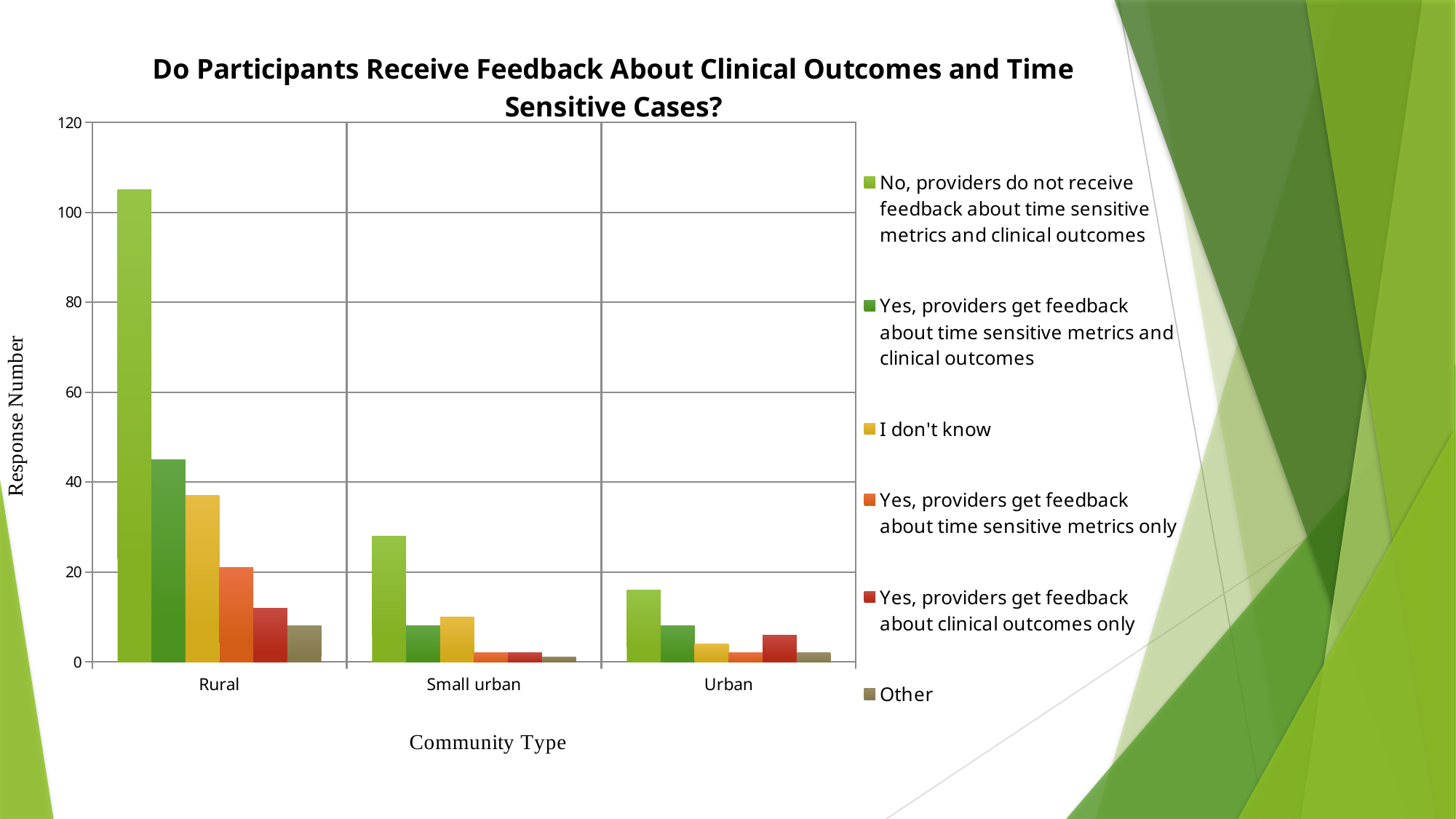
Which series has the lowest bar in the Rural group? Other In Rural, which is larger: "I don't know" or "Yes, providers get feedback about time sensitive metrics only"? I don't know What is the title of the x axis? Community Type Is the value for "No, providers do not receive feedback about time sensitive metrics and clinical outcomes" in Rural greater or less than 100? greater How many series does the legend list? 6 What kind of chart is shown on the slide? bar chart Is the value for "Yes, providers get feedback about time sensitive metrics and clinical outcomes" in Rural greater or less than 40? greater How many community types are shown on the x axis? 3 Which community type has the highest bar for "No, providers do not receive feedback about time sensitive metrics and clinical outcomes"? Rural Does the "No, providers do not receive feedback about time sensitive metrics and clinical outcomes" series rise or fall from Rural to Urban? fall What is the title of the y axis? Response Number Is the value for "No, providers do not receive feedback about time sensitive metrics and clinical outcomes" in Small urban greater or less than 20? greater